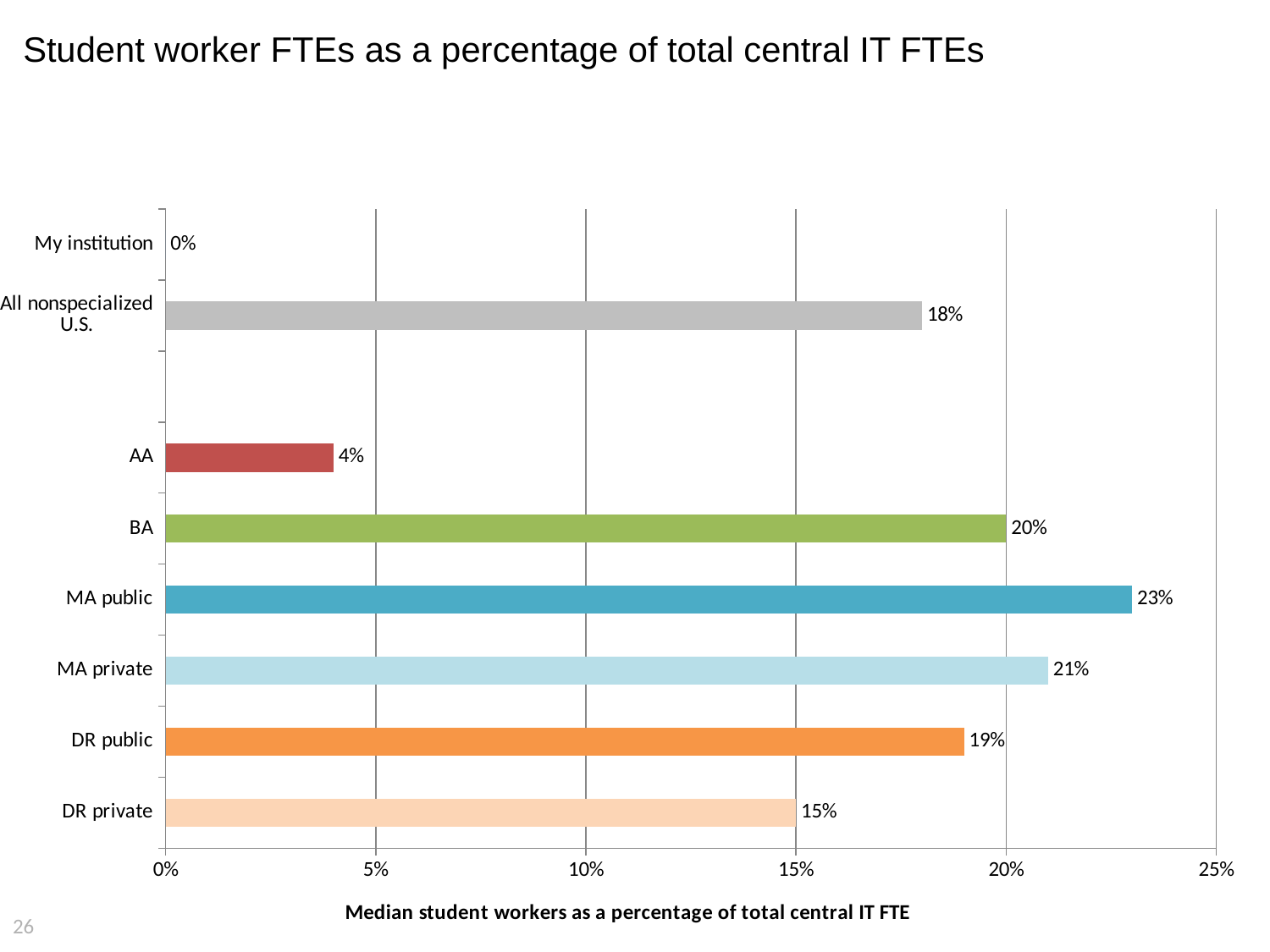
What is the value for DR private? 15% Which is larger, the value for MA private or the value for DR public? MA private What is the x-axis title of the chart? Median student workers as a percentage of total central IT FTE How many categories are shown on the chart? 8 What is the value for MA public? 23% What is the difference between the values for BA and DR public? 1% What kind of chart is shown on the slide? bar chart Which category has the highest value? MA public What is the value for All nonspecialized U.S.? 18% What is the difference between the values for MA public and AA? 19% Is the value for BA greater or less than 15%? greater Which category has the lowest non-zero value? AA